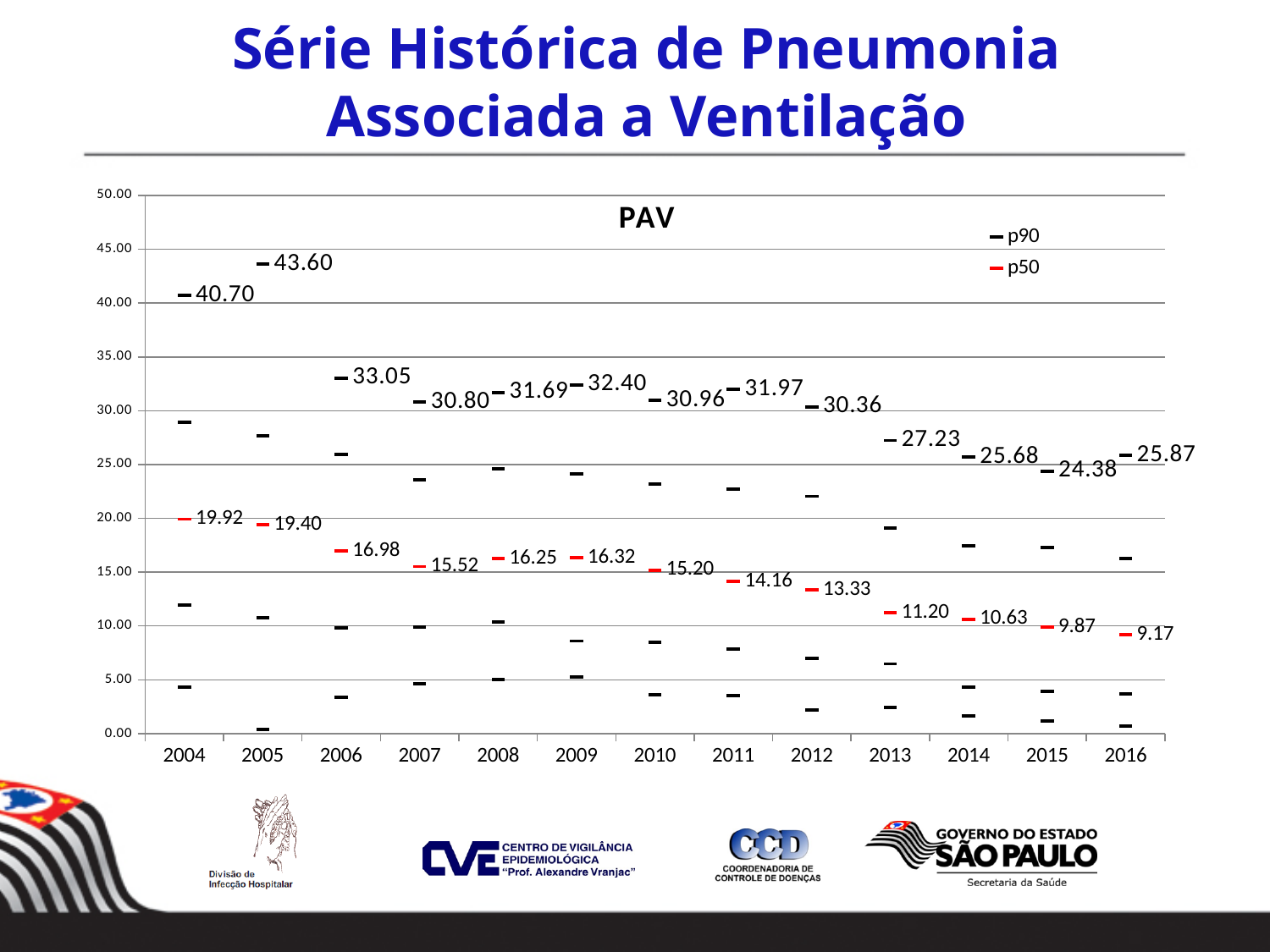
Does the p50 value generally rise or fall from 2004 to 2016? fall What is the p50 value for 2012? 13.33 In which year is the p90 value highest? 2005 What is the difference between the p90 values for 2005 and 2004? 2.90 How many series does the legend list? 2 In which year is the p50 value lowest? 2016 What is the difference between the p90 and p50 values in 2016? 16.70 What is the p90 value for 2013? 27.23 What is the p90 value for 2004? 40.70 How many years are shown on the x axis? 13 Which year has the larger p50 value, 2008 or 2009? 2009 What is the p50 value for 2016? 9.17